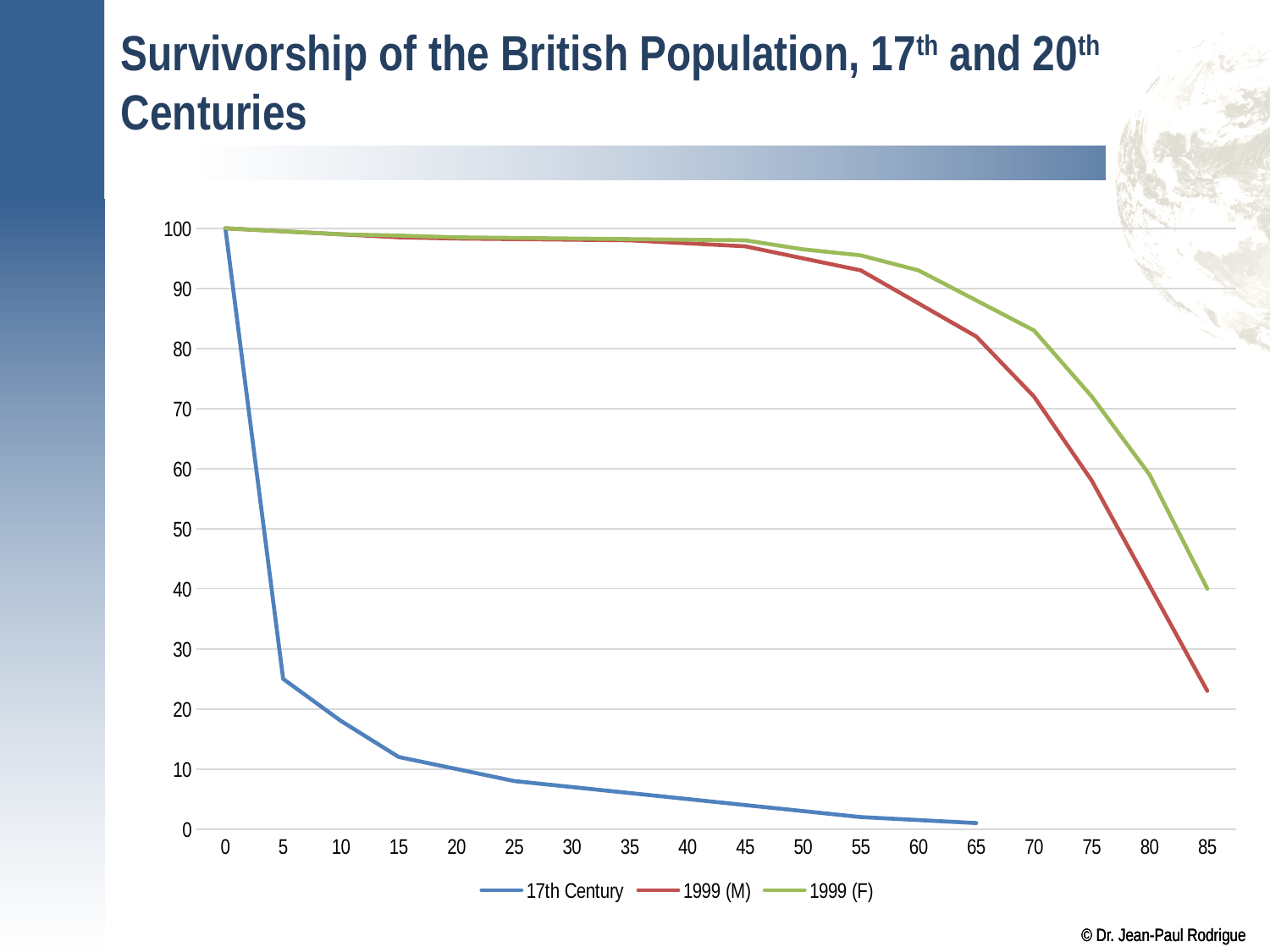
What is the value of the 1999 (F) series at age 85? 40 What is the value of the 17th Century series at age 0? 100 Do the values of the 1999 (M) series rise or fall as age increases along the x axis? Fall How many series does the legend list? 3 Is the value for the 1999 (M) series at age 75 greater or less than 60? less Is the value for the 1999 (M) series at age 85 greater or less than 20? greater What kind of chart is shown on the slide? Line chart At age 5, which series has the larger value, 17th Century or 1999 (M)? 1999 (M) Is the value for the 1999 (F) series at age 70 greater or less than 80? greater At age 85, which series has the larger value, 1999 (M) or 1999 (F)? 1999 (F) What is the title of the chart on the slide? Survivorship of the British Population, 17th and 20th Centuries